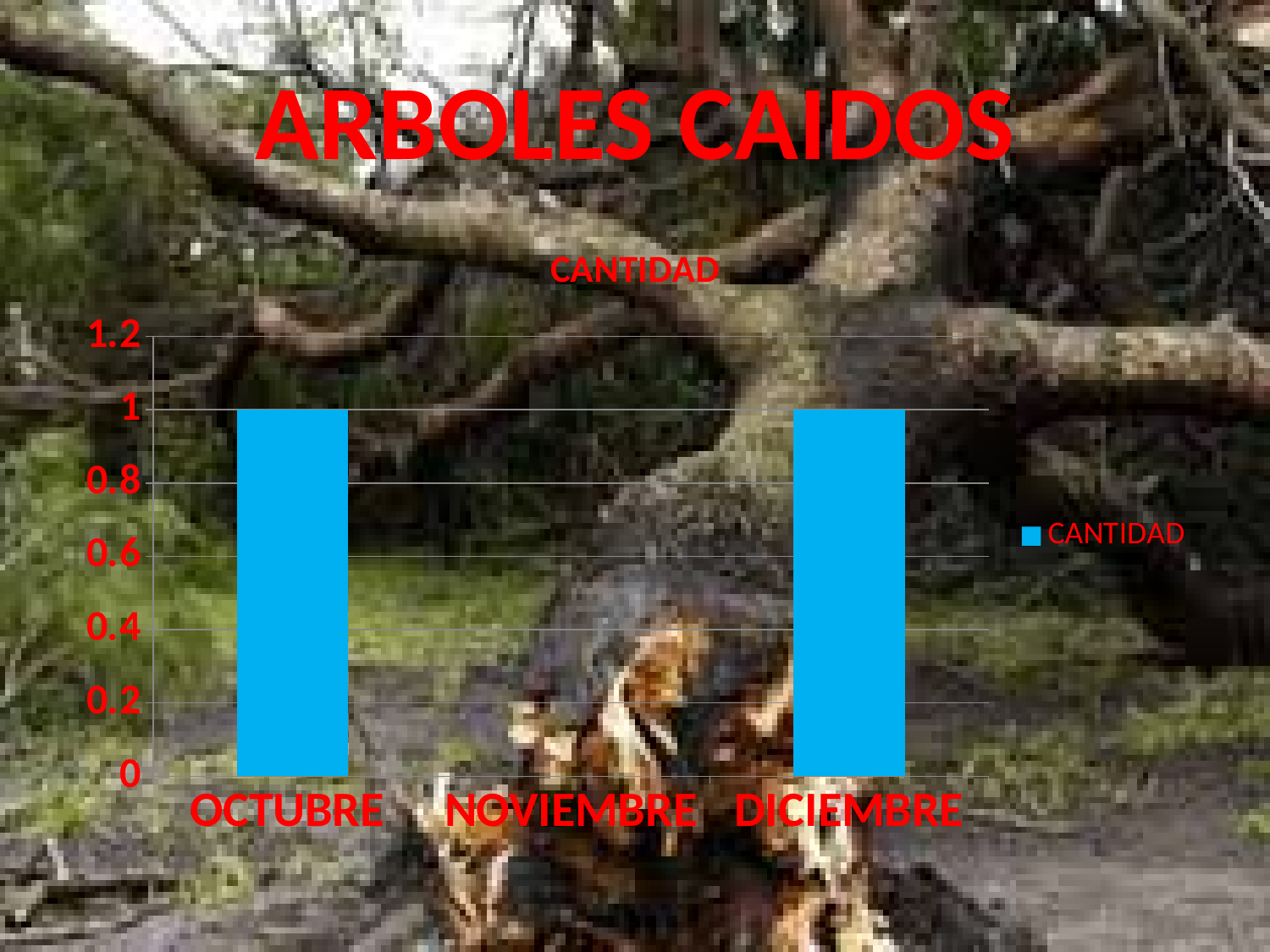
Which category has the lowest value? NOVIEMBRE What is the value for DICIEMBRE? 1 Is the value for OCTUBRE greater or less than 0.6? greater What is the value for OCTUBRE? 1 What is the difference between the values for OCTUBRE and DICIEMBRE? 0 What kind of chart is shown on the slide? bar chart How many categories are shown on the x axis of the chart? 3 Is the value for DICIEMBRE greater or less than 0.4? greater Which is larger, the value for DICIEMBRE or the value for NOVIEMBRE? DICIEMBRE What is the title of the chart? CANTIDAD Which is larger, the value for OCTUBRE or the value for NOVIEMBRE? OCTUBRE How many series does the chart legend list? 1